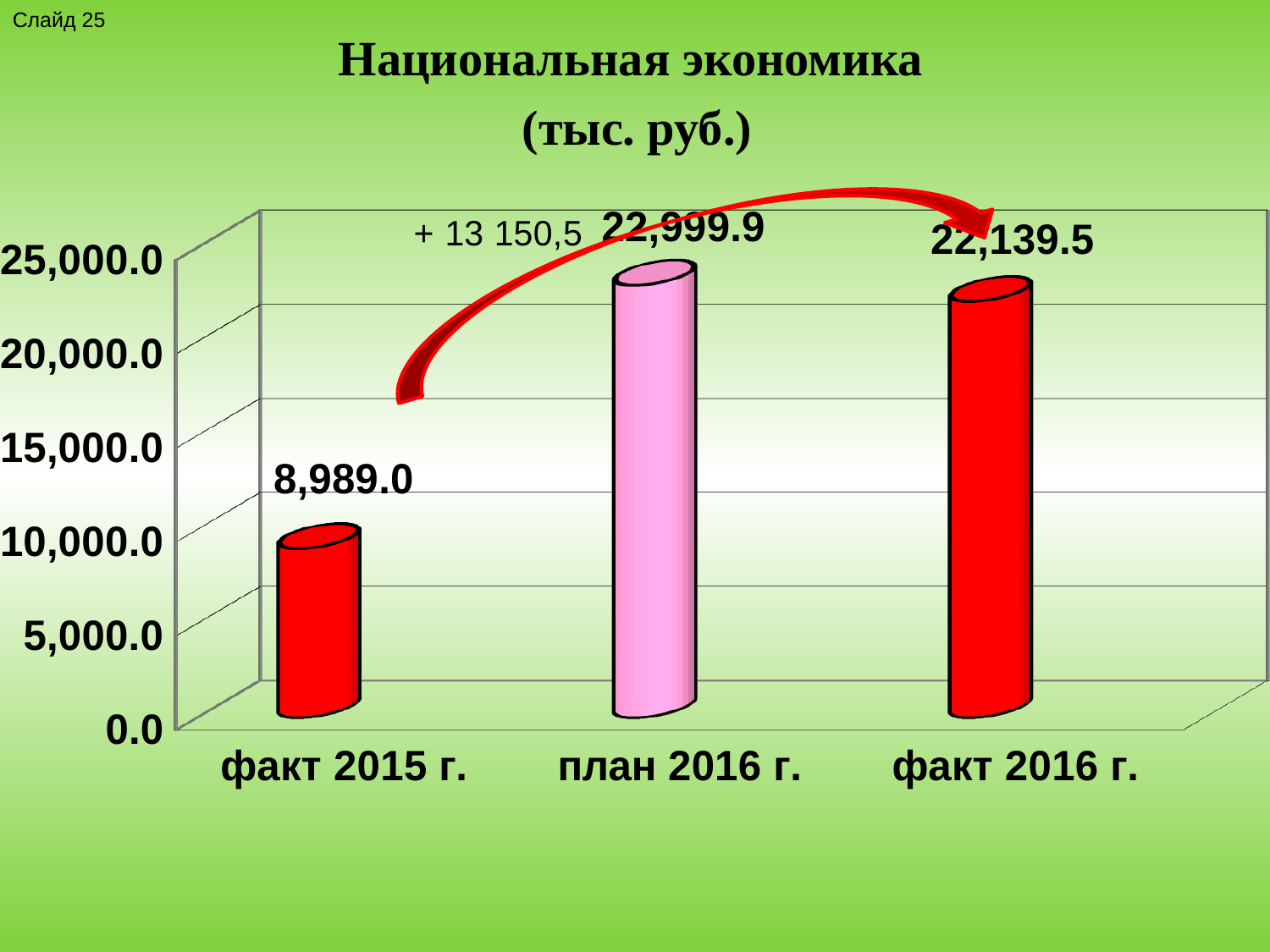
What is the value for факт 2016 г.? 22,139.5 Which is larger, the value for факт 2015 г. or the value for факт 2016 г.? факт 2016 г. Is the value for факт 2015 г. greater or less than 10,000.0? less Which category has the highest value? план 2016 г. What is the difference between факт 2016 г. and факт 2015 г.? 13,150.5 What is the value for факт 2015 г.? 8,989.0 What kind of chart is shown on the slide? bar chart What is the value for план 2016 г.? 22,999.9 What is the difference between план 2016 г. and факт 2016 г.? 860.4 Which category has the lowest value? факт 2015 г. What is the title of the chart? Национальная экономика (тыс. руб.) How many categories are shown on the x axis? 3